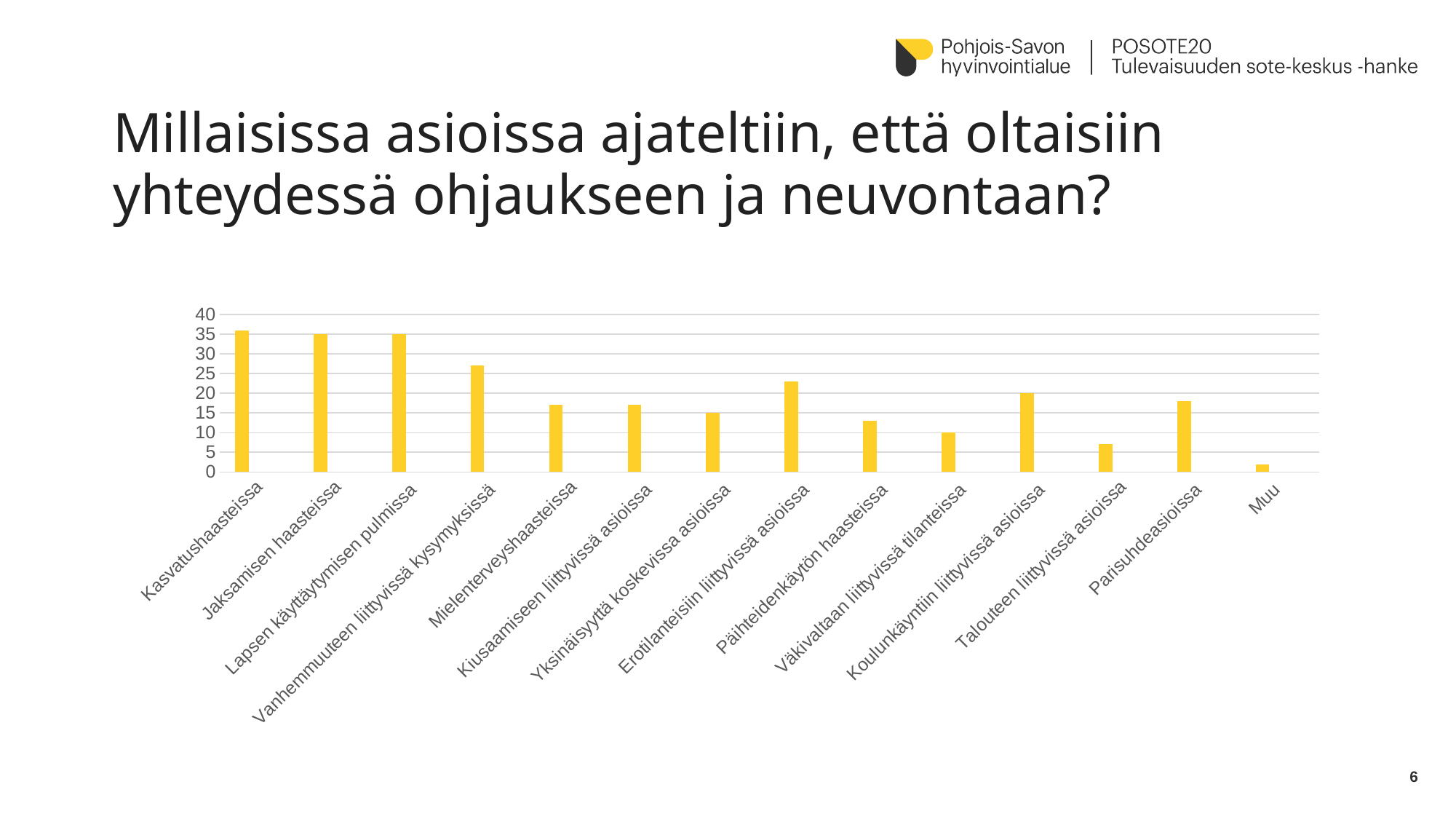
Is the value for Muu greater or less than 5? less Is the value for Erotilanteisiin liittyvissä asioissa greater or less than 20? greater Which category has the lowest value in the chart? Muu What kind of chart is shown on the slide? bar chart What colour are the bars in the chart? yellow How many categories are shown on the x axis of the chart? 14 Is the value for Päihteidenkäytön haasteissa greater or less than 15? less Which is larger, the value for Vanhemmuuteen liittyvissä kysymyksissä or the value for Erotilanteisiin liittyvissä asioissa? Vanhemmuuteen liittyvissä kysymyksissä Which is larger, the value for Parisuhdeasioissa or the value for Talouteen liittyvissä asioissa? Parisuhdeasioissa